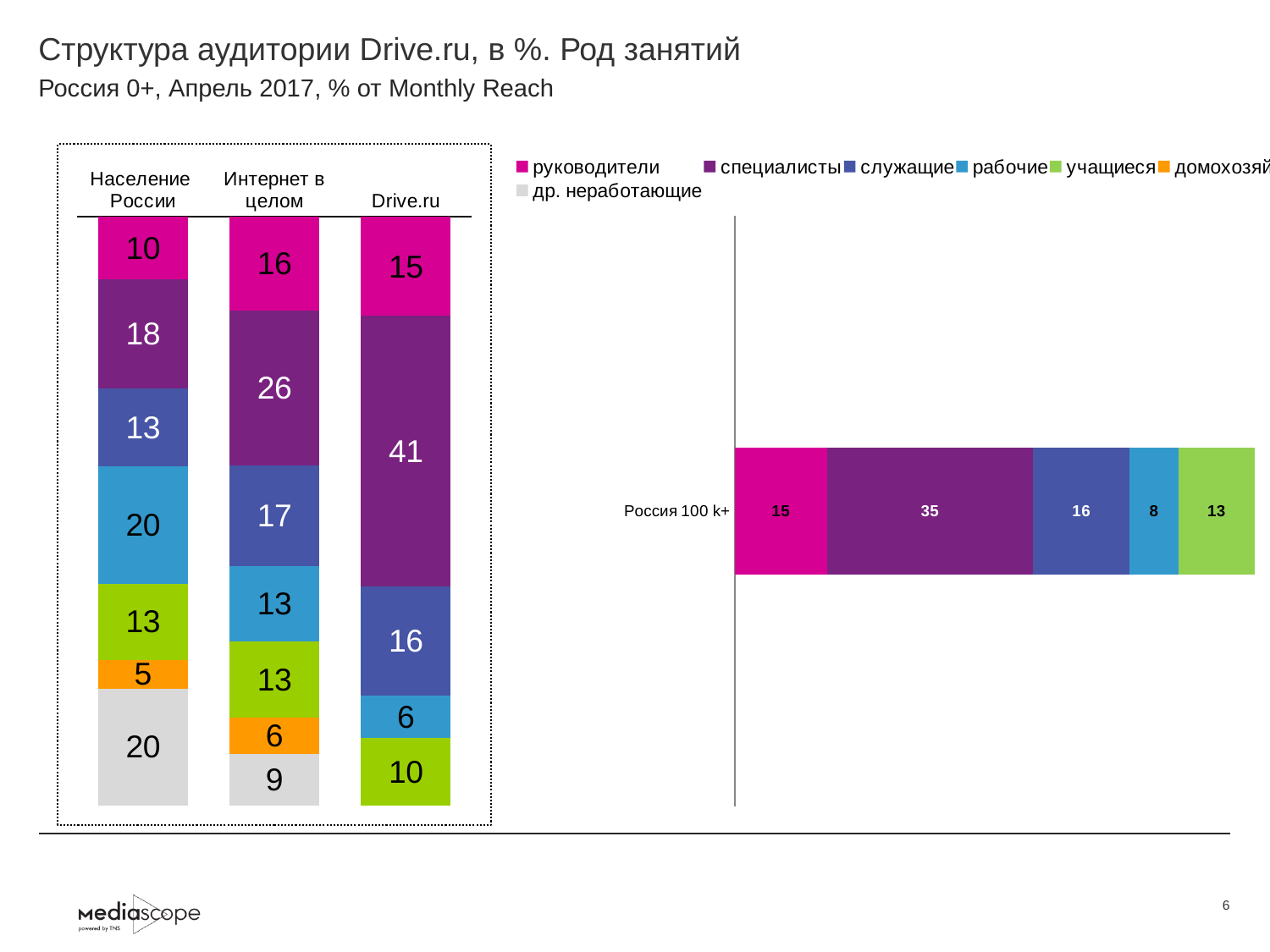
In the right chart, what is the value for специалисты for Россия 100 k+? 35 In the left chart, what is the difference between the специалисты values for Drive.ru and Интернет в целом? 15 In the left chart, what is the value for руководители in the Интернет в целом column? 16 In the right chart, what is the total of the Россия 100 k+ bar? 87 What type of chart is the right chart (Россия 100 k+)? Stacked bar chart How many series does the legend list? 7 In the left chart, which segment is the smallest in the Население России column? домохозяйки (5) In the left chart, how many columns (audience groups) are shown? 3 In the left chart, which is larger: рабочие for Население России or рабочие for Drive.ru? Население России In the left chart, which column has the largest специалисты segment? Drive.ru In the left chart, what is the value for специалисты in the Drive.ru column? 41 In the left chart, what is the value for др. неработающие in the Население России column? 20